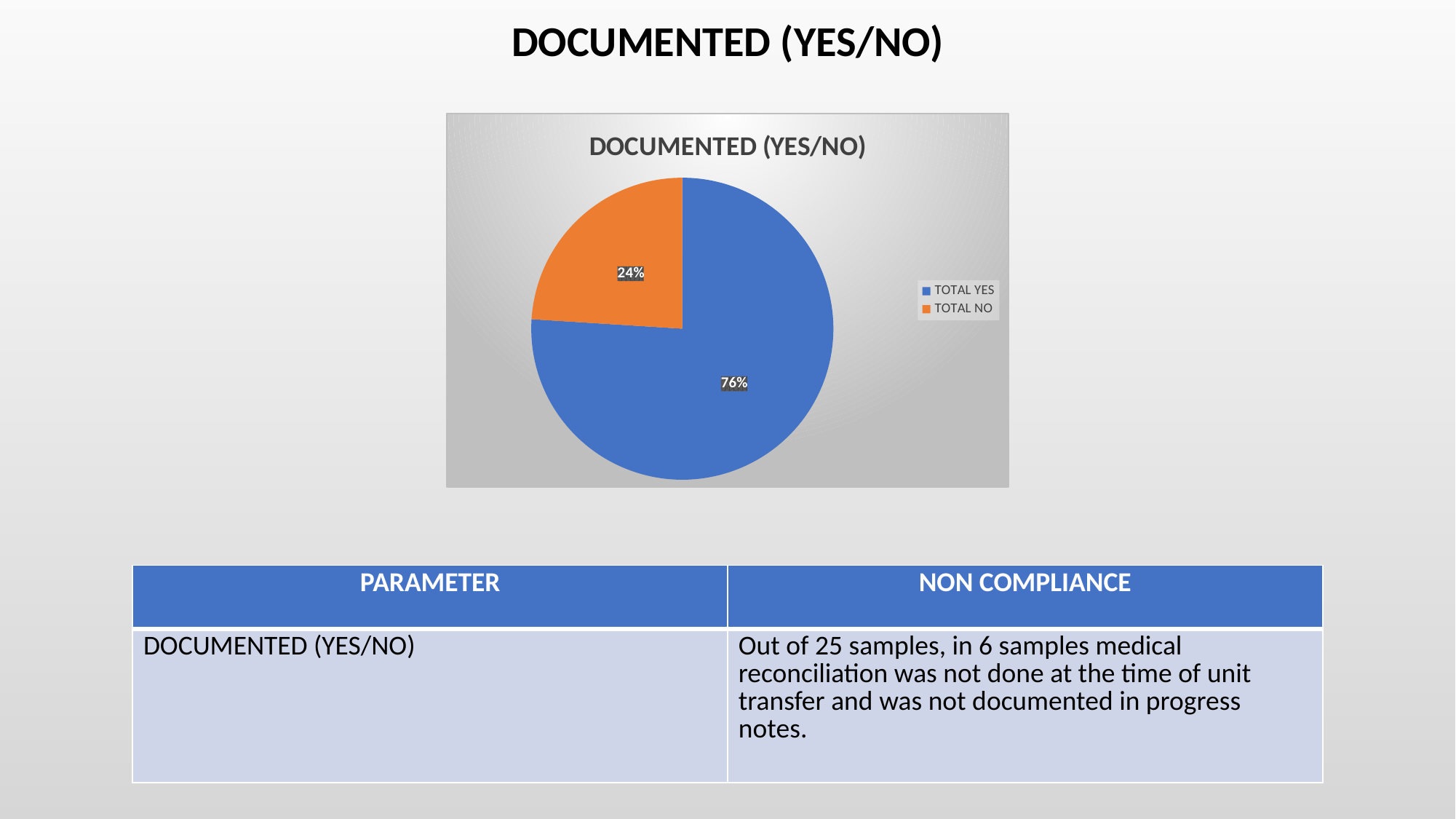
Which slice is the smallest in the pie chart? TOTAL NO What share of the pie does TOTAL NO represent? 24% How many slices does the pie chart have? 2 What is the difference in percentage points between the TOTAL YES and TOTAL NO slices? 52 percentage points How many entries does the legend list? 2 What kind of chart is shown on the slide? pie chart What share of the pie does TOTAL YES represent? 76% What colour is the TOTAL NO slice? orange Which is larger, the TOTAL YES slice or the TOTAL NO slice? TOTAL YES Which slice is the largest in the pie chart? TOTAL YES What is the title of the chart? DOCUMENTED (YES/NO)